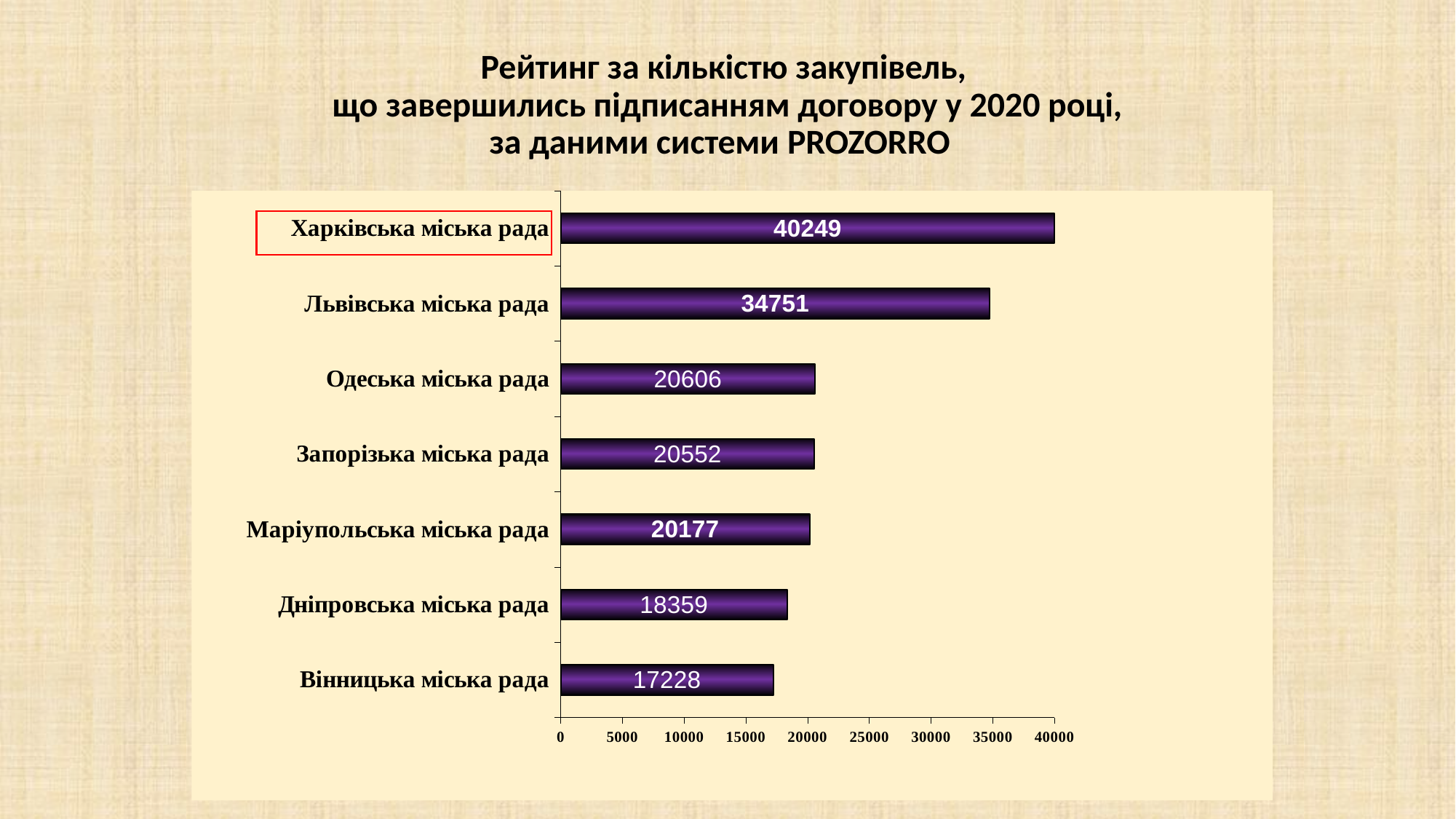
Which has a larger value, Одеська міська рада or Запорізька міська рада? Одеська міська рада What is the difference between the values for Дніпровська міська рада and Вінницька міська рада? 1131 Which city council has the lowest value? Вінницька міська рада What is the value for Вінницька міська рада? 17228 Which city council has the highest value? Харківська міська рада What is the difference between the values for Харківська міська рада and Львівська міська рада? 5498 Is the value for Львівська міська рада greater or less than 30000? greater How many city councils are shown in the chart? 7 Which category label is outlined with a red box? Харківська міська рада What kind of chart is shown on the slide? bar chart What is the value for Маріупольська міська рада? 20177 What is the value for Харківська міська рада? 40249